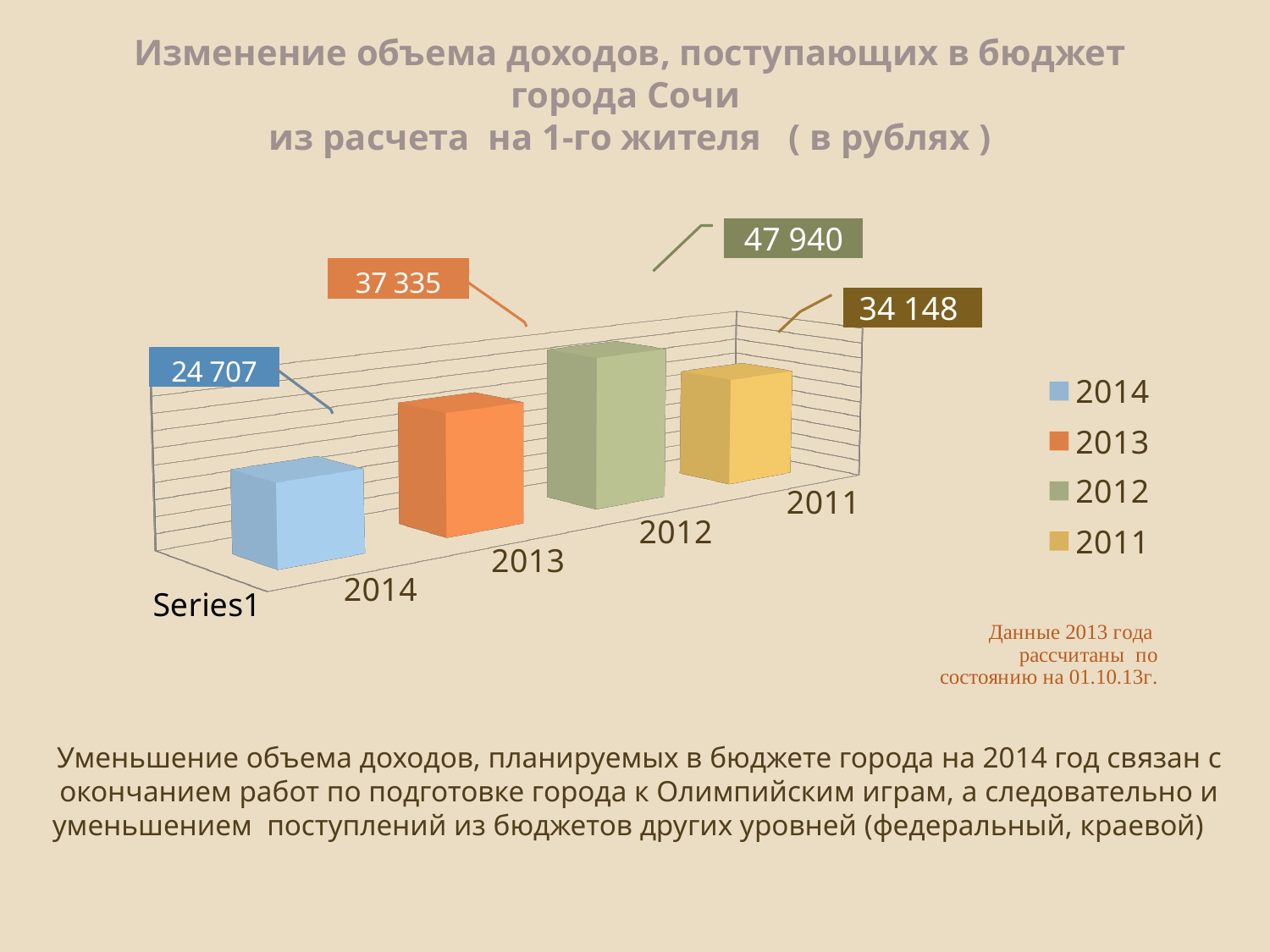
Which is larger, the value for 2013 or the value for 2011? 2013 How many bars are plotted in the chart? 4 What is the difference between the values for 2012 and 2014? 23 233 What kind of chart is shown on the slide? bar chart What is the difference between the values for 2013 and 2011? 3 187 Which year has the highest value? 2012 What is the value shown for 2014? 24 707 What is the value shown for 2013? 37 335 Which year has the lowest value? 2014 What is the value shown for 2012? 47 940 What is the value shown for 2011? 34 148 How many entries does the legend list? 4